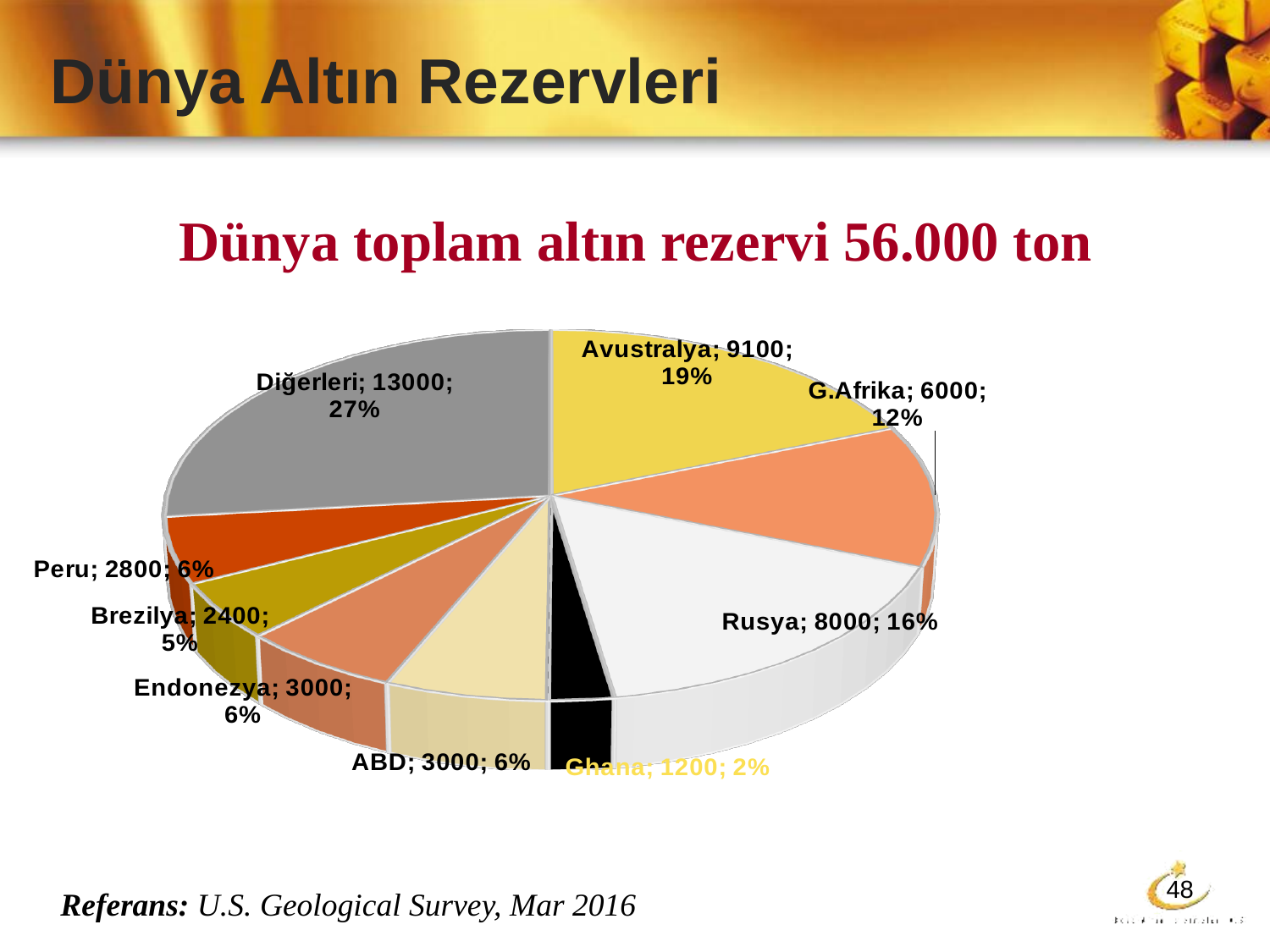
Which slice has the largest share of the pie? Diğerleri What is the difference between the values for Avustralya and Rusya? 1100 How many slices does the pie chart have? 9 What is the difference between the values for Endonezya and Brezilya? 600 What is the title of the slide containing the chart? Dünya Altın Rezervleri What is the value shown for Avustralya? 9100 Which slice has the smallest share of the pie? Ghana What share of the pie does Brezilya have? 5% What is the value shown for Ghana? 1200 What share of the pie does Rusya have? 16% What kind of chart is shown on the slide? pie chart Which is larger, the value for G.Afrika or the value for Peru? G.Afrika